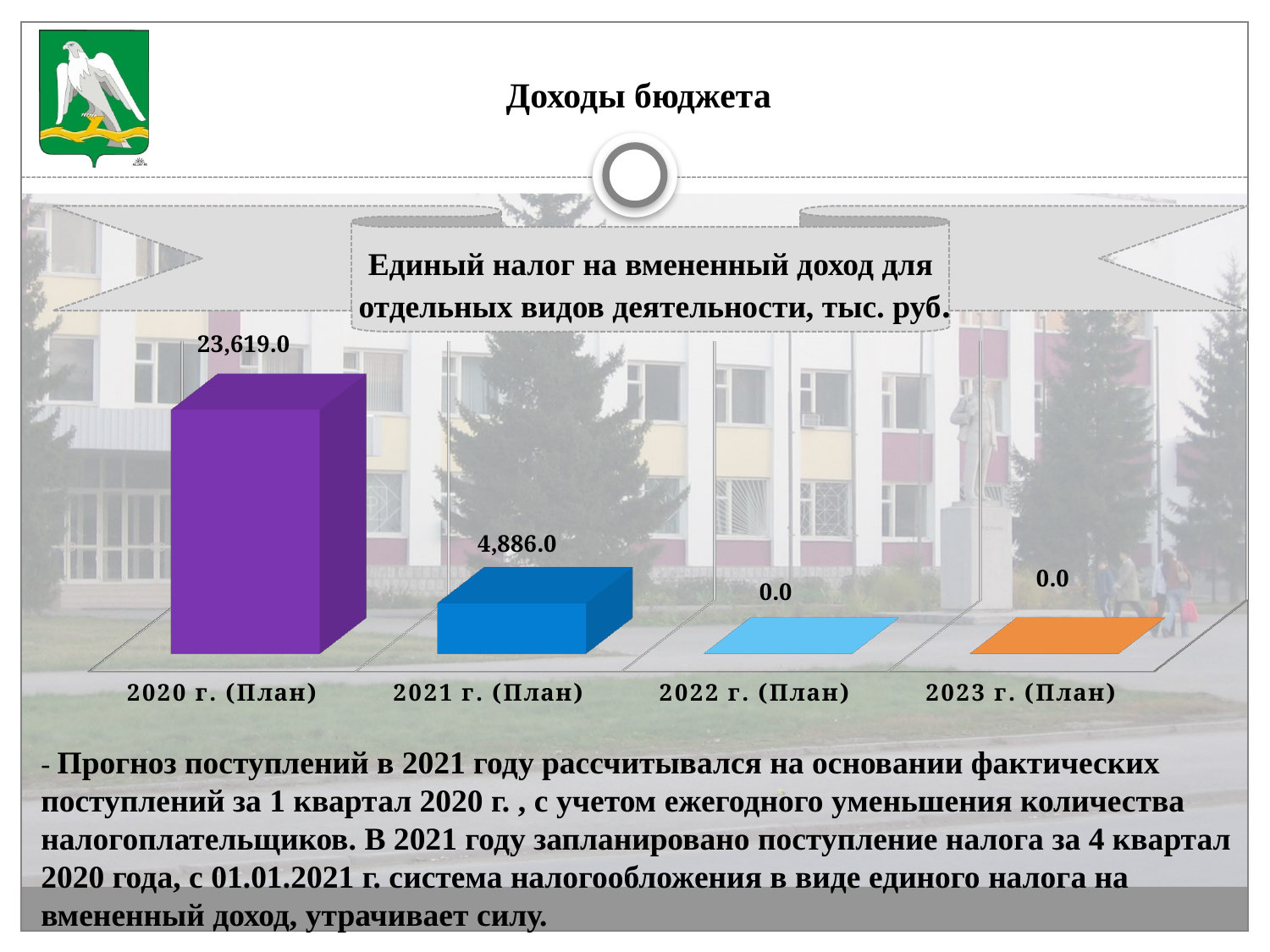
What colour is the bar for 2020 г. (План)? purple What is the value for 2020 г. (План)? 23,619.0 How many categories are shown on the chart? 4 What is the difference between the values for 2020 г. (План) and 2021 г. (План)? 18,733.0 Do the values rise or fall from 2020 г. (План) to 2022 г. (План)? fall What is the title of the chart? Единый налог на вмененный доход для отдельных видов деятельности, тыс. руб. What is the value for 2021 г. (План)? 4,886.0 Which is larger, the value for 2020 г. (План) or 2021 г. (План)? 2020 г. (План) Which category has the highest value? 2020 г. (План) What is the value for 2023 г. (План)? 0.0 What kind of chart is shown on the slide? bar chart What is the value for 2022 г. (План)? 0.0